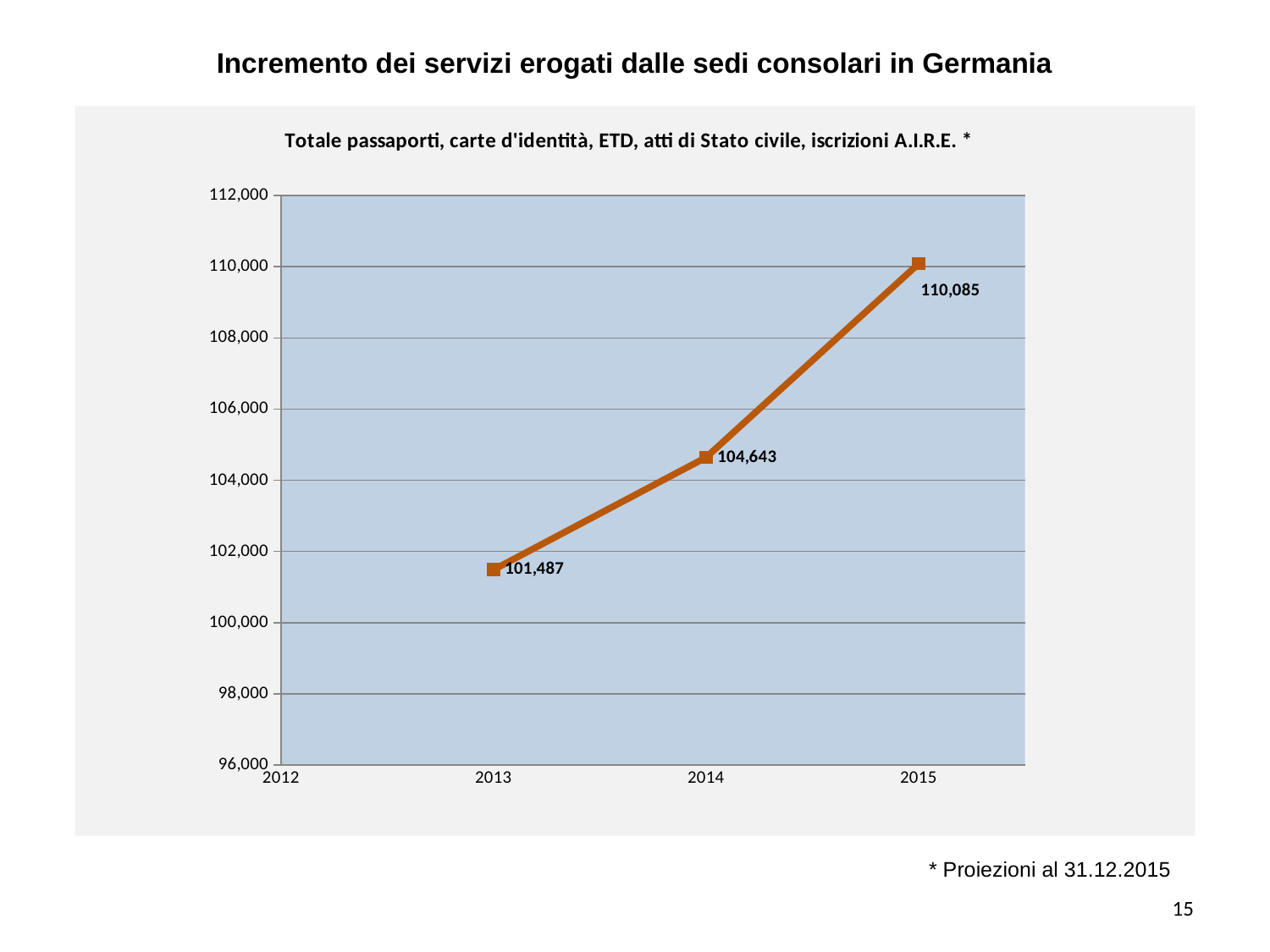
What is the difference between the 2014 value and the 2013 value? 3,156 What is the difference between the 2015 value and the 2013 value? 8,598 What is the value plotted for 2013? 101,487 What is the value plotted for 2014? 104,643 Is the value for 2015 greater or less than 108,000? greater How many data points are plotted on the line? 3 Which year has the highest value? 2015 Which is larger, the value for 2014 or the value for 2013? 2014 What kind of chart is shown? line chart What is the value plotted for 2015? 110,085 What is the difference between the 2015 value and the 2014 value? 5,442 Which year has the lowest value? 2013